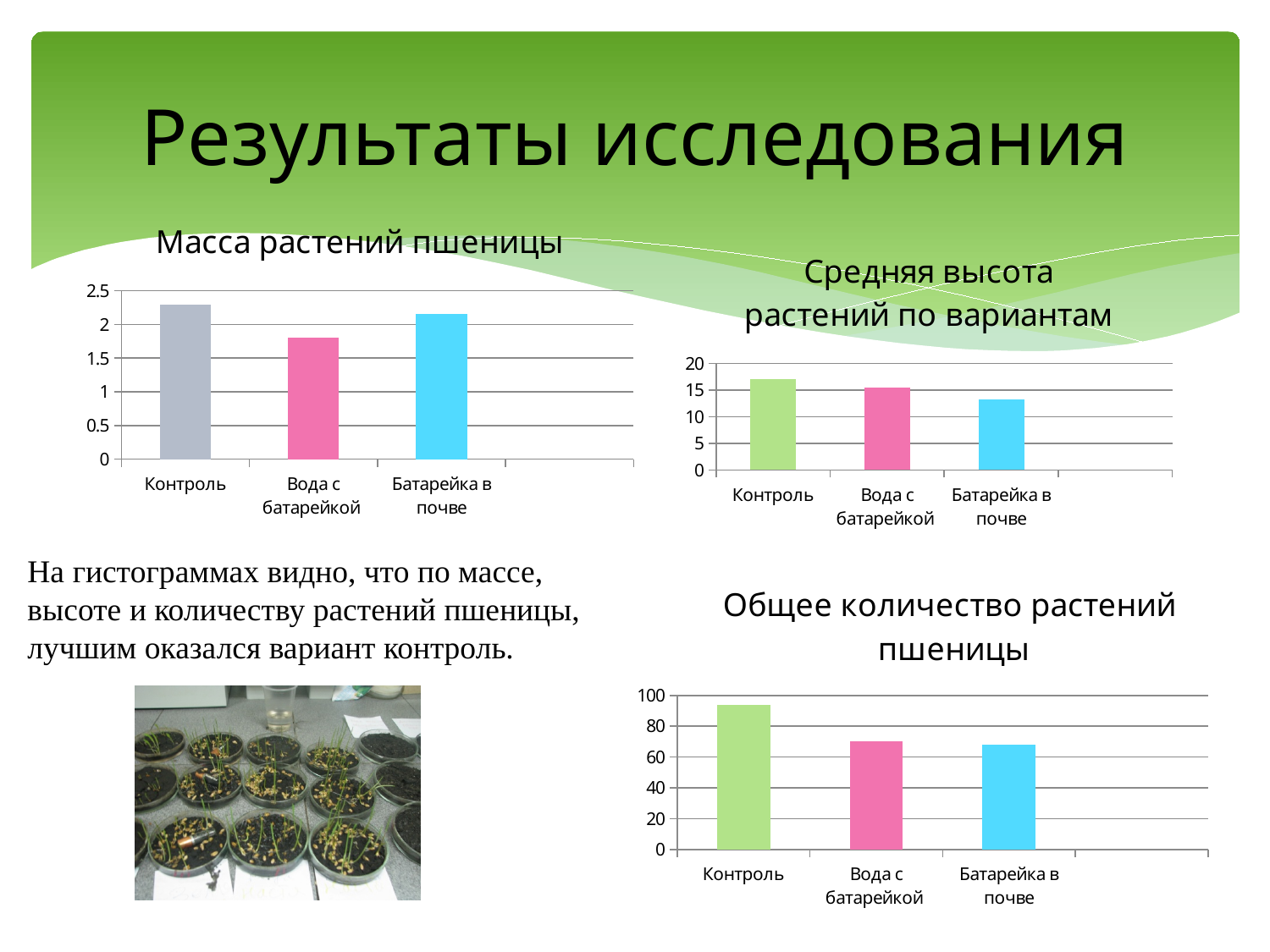
In the chart titled "Средняя высота растений по вариантам", which category has the lowest value? Батарейка в почве In the chart titled "Средняя высота растений по вариантам", is the value for Контроль greater or less than 15? greater In the chart titled "Масса растений пшеницы", which category has the lowest value? Вода с батарейкой How many categories are shown in the chart titled "Общее количество растений пшеницы"? 3 In the chart titled "Общее количество растений пшеницы", is the value for Контроль greater or less than 80? greater What kind of chart is the chart titled "Средняя высота растений по вариантам"? bar chart In the chart titled "Общее количество растений пшеницы", which is larger, the value for Контроль or the value for Вода с батарейкой? Контроль In the chart titled "Общее количество растений пшеницы", which category has the highest value? Контроль In the chart titled "Масса растений пшеницы", is the value for Контроль greater or less than 2? greater In the chart titled "Масса растений пшеницы", which category has the highest value? Контроль